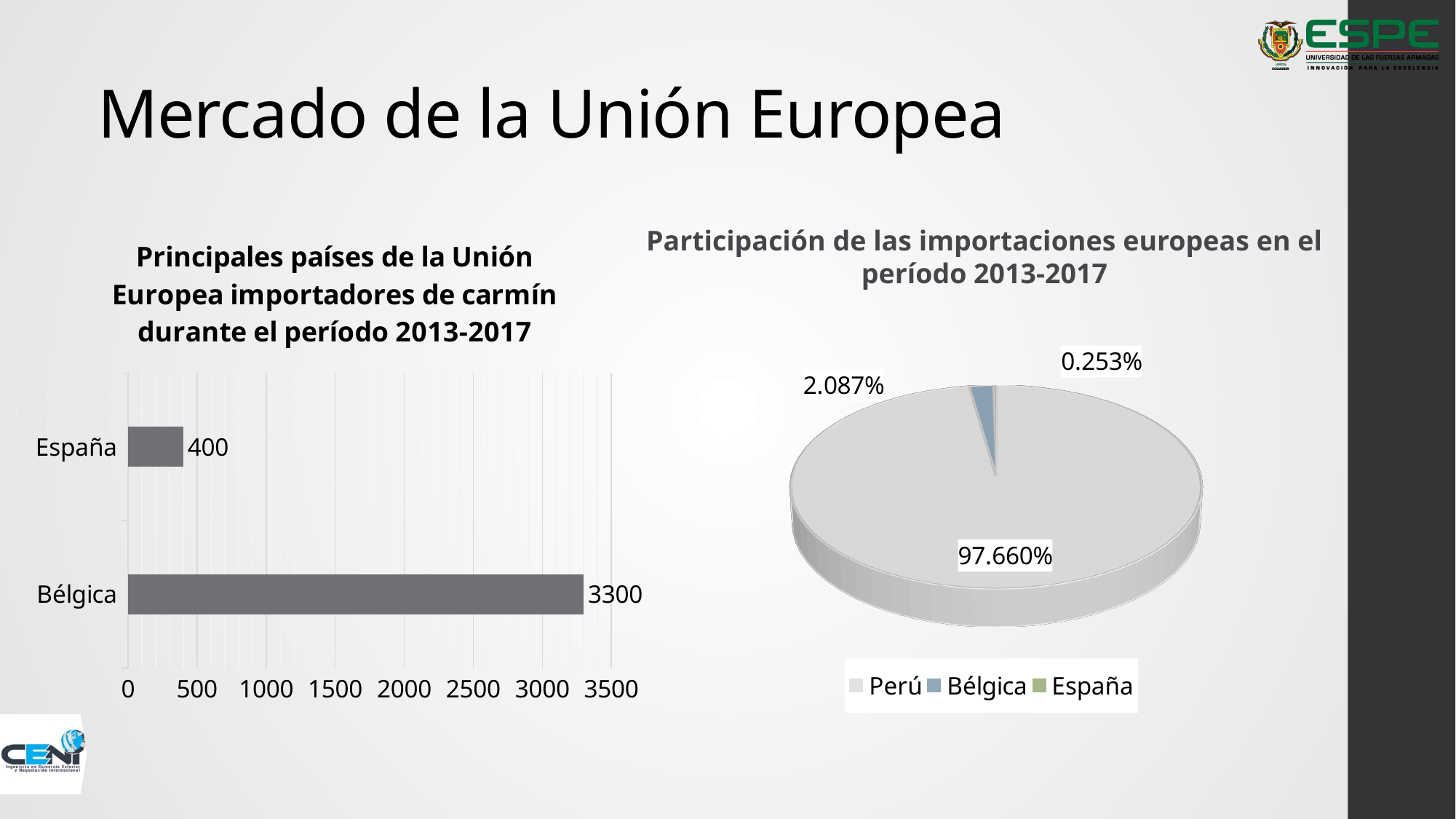
In the bar chart on the left, how many countries are shown? 2 What kind of chart is the chart on the left of the slide? Bar chart In the bar chart on the left, which country has the highest value? Bélgica In the pie chart 'Participación de las importaciones europeas en el período 2013-2017', what share does Perú have? 97.660% In the bar chart on the left, what is the value for España? 400 What kind of chart is the chart on the right of the slide? Pie chart In the pie chart on the right, what share does España have? 0.253% In the pie chart on the right, how many entries does the legend list? 3 In the bar chart on the left, which country has the lowest value? España In the bar chart on the left, what is the difference between the values for Bélgica and España? 2900 In the pie chart on the right, what share does Bélgica have? 2.087% In the bar chart 'Principales países de la Unión Europea importadores de carmín durante el período 2013-2017', what is the value for Bélgica? 3300